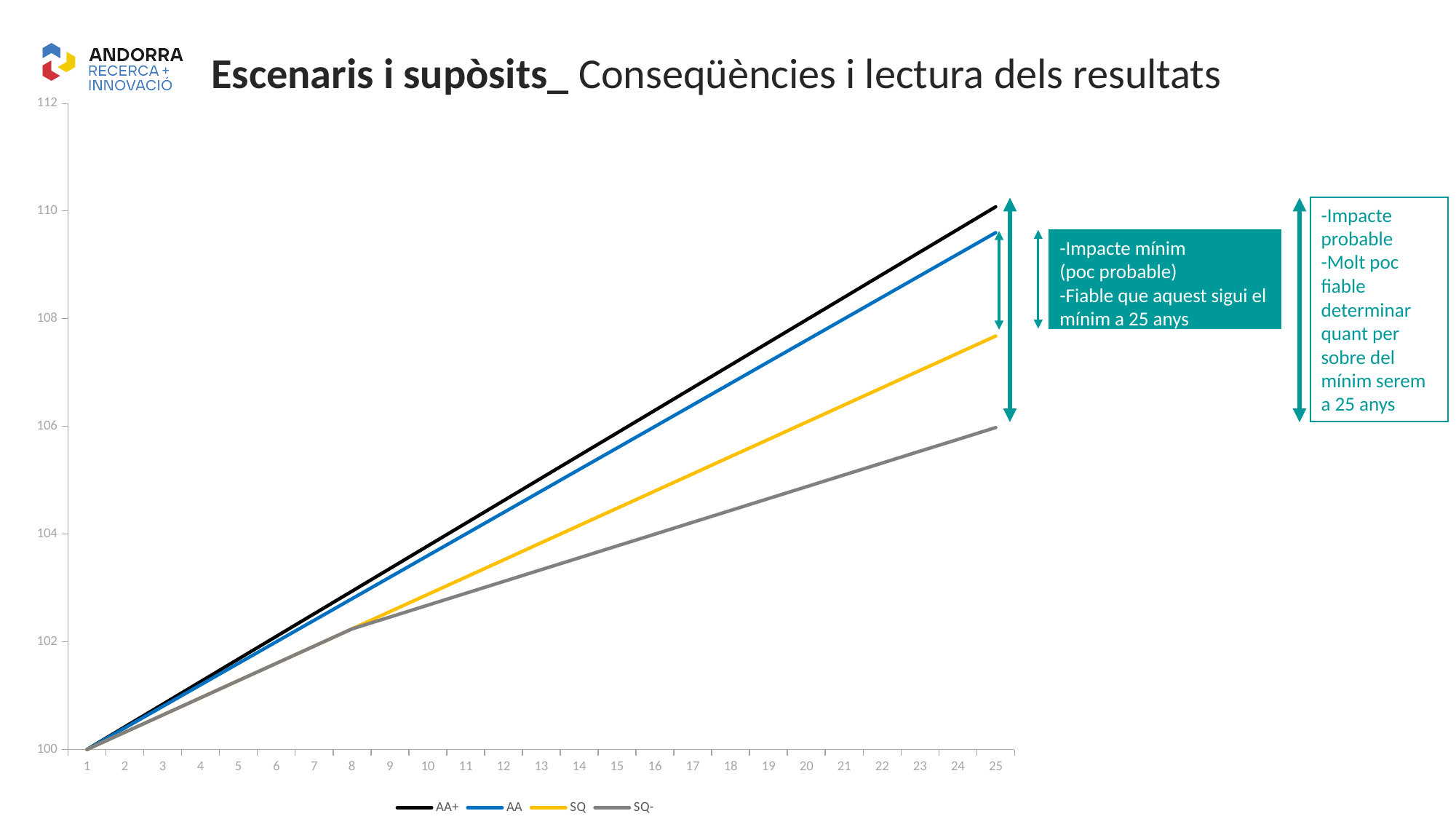
How many points are there along the x axis? 25 Which series has the highest value at x = 25? AA+ Which series has the lowest value at x = 25? SQ- What is the value of all four series at x = 1? 100 Do the values of the AA series rise or fall as x increases from 1 to 25? rise Is the value for AA+ at x = 25 greater or less than 108? greater At x = 25, which is larger, the value for AA or the value for SQ? AA How many series does the legend list? 4 Is the value for SQ at x = 25 greater or less than 106? greater Is the value for SQ- at x = 25 greater or less than 108? less What kind of chart is shown on the slide? line chart What colour is the SQ line in the legend? yellow